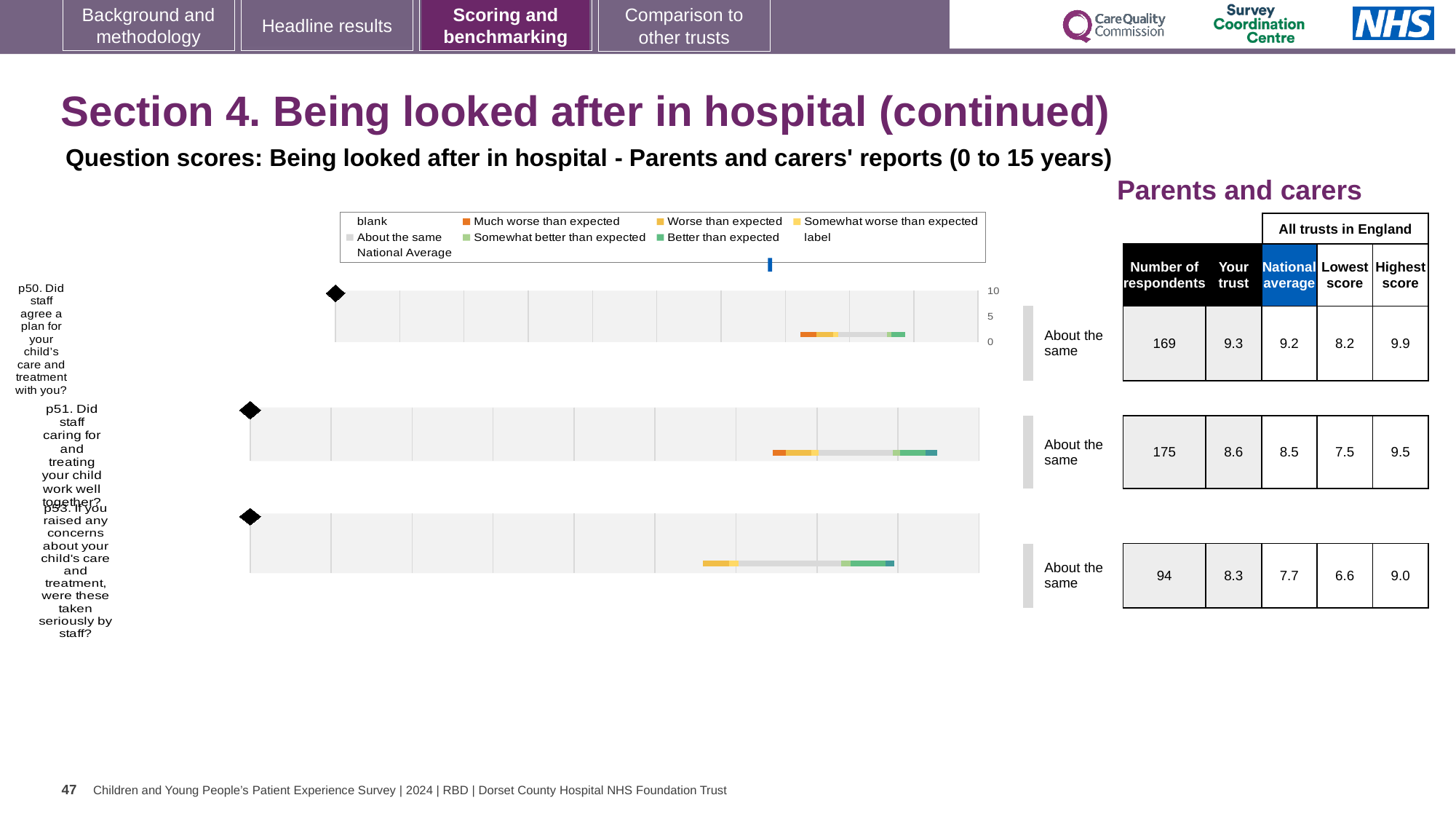
What is the 'Your trust' score for p50 (Did staff agree a plan for your child's care and treatment with you)? 9.3 How many respondents answered p53 (If you raised any concerns about your child's care and treatment, were these taken seriously by staff)? 94 Which question has the highest 'Your trust' score? p50 What benchmark category is shown for p50? About the same What kind of chart is used to show the question scores on this slide? bar chart What is the highest score across all trusts in England for p50? 9.9 Which legend entry is shown in orange? Much worse than expected How many survey questions are plotted on this slide? 3 For p53, what is the difference between the 'Your trust' score and the national average? 0.6 For p51, which is larger: the 'Your trust' score or the national average? Your trust What is the national average score for p51 (Did staff caring for and treating your child work well together)? 8.5 Which question has the lowest 'Lowest score' among all trusts in England? p53